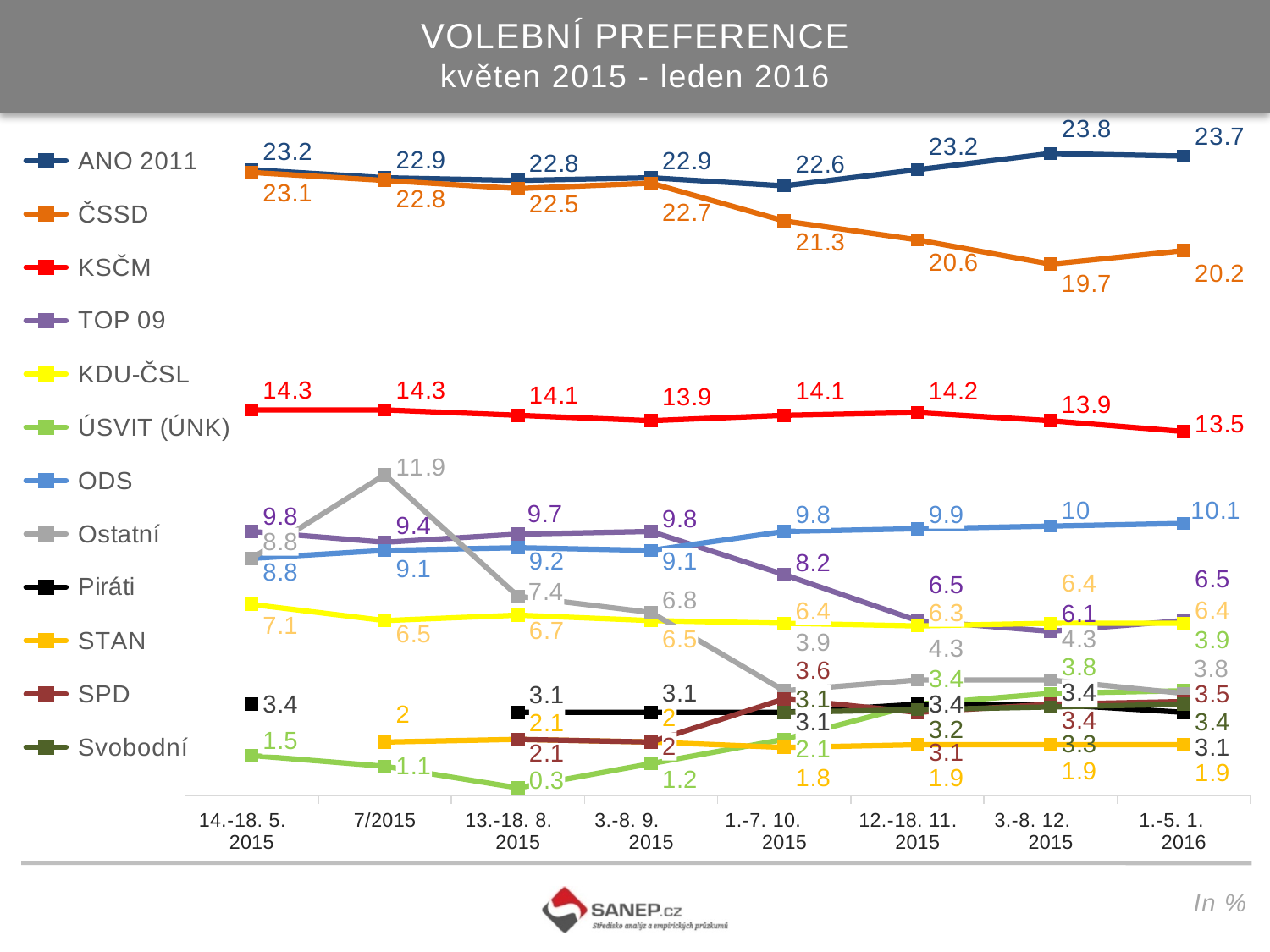
At which survey date does ANO 2011 reach its highest value? 3.-8. 12. 2015 At which survey date does ČSSD have its lowest value? 3.-8. 12. 2015 How many survey dates are shown on the x axis? 8 What is the value for ČSSD at 3.-8. 12. 2015? 19.7 What is the difference between ANO 2011 and ČSSD at 1.-5. 1. 2016? 3.5 Does the value for ODS rise or fall from 14.-18. 5. 2015 to 1.-5. 1. 2016? rise How many series does the legend list? 12 What is the value for KSČM at 1.-5. 1. 2016? 13.5 What is the value for ANO 2011 at 1.-5. 1. 2016? 23.7 What kind of chart is shown on the slide? line chart Which is larger at 1.-5. 1. 2016, ODS or TOP 09? ODS What is the value for Ostatní at 7/2015? 11.9